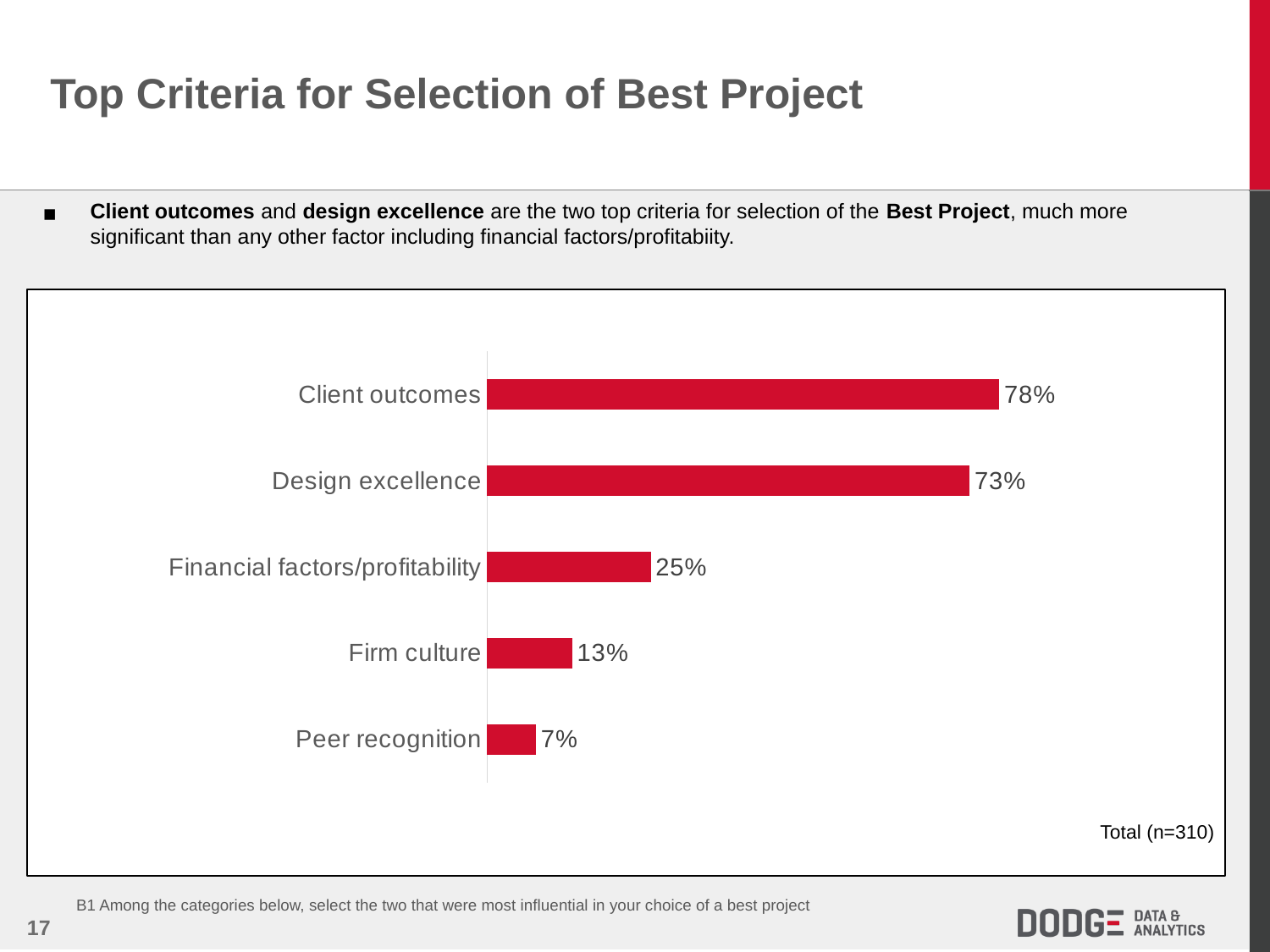
What percentage is shown for Peer recognition? 7% Which category has the lowest value? Peer recognition Which is larger, the value for Firm culture or the value for Peer recognition? Firm culture How many categories are shown in the chart? 5 What percentage is shown for Firm culture? 13% What percentage is shown for Client outcomes? 78% What is the difference between the values for Client outcomes and Design excellence? 5% Which category has the highest value? Client outcomes What is the difference between the values for Financial factors/profitability and Firm culture? 12% What percentage is shown for Financial factors/profitability? 25% What kind of chart is shown on the slide? Bar chart What percentage is shown for Design excellence? 73%